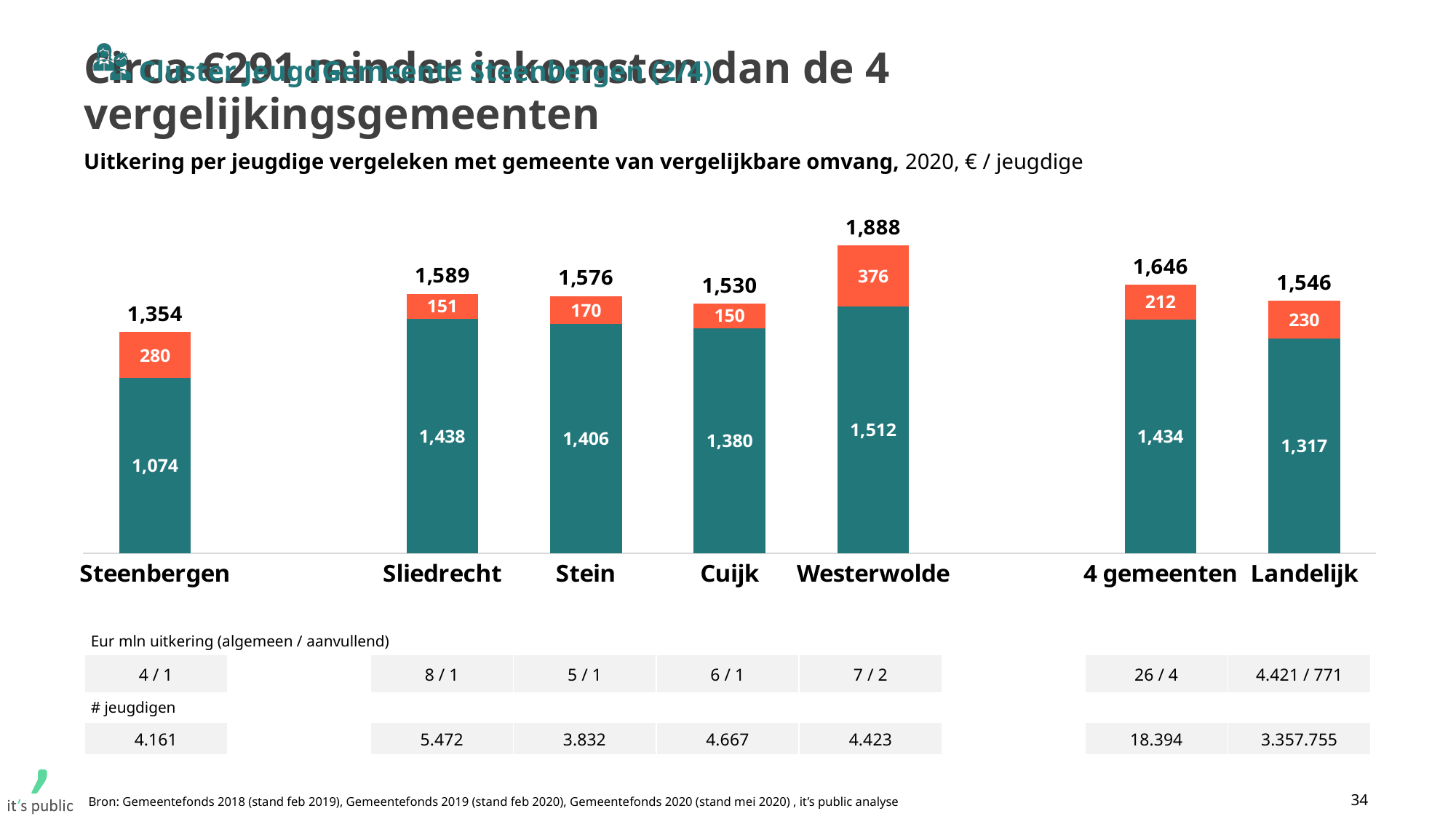
What kind of chart is shown on the slide? Stacked bar chart Which category has the highest total value? Westerwolde What is the difference between the teal (bottom) segments of Westerwolde and Cuijk? 132 What is the total value shown above the bar for Westerwolde? 1,888 What is the value of the orange (top) segment of the Landelijk bar? 230 What unit is stated in the chart subtitle for the values? € / jeugdige What is the total of the Cuijk bar? 1,530 How many categories are shown on the x axis of the chart? 7 Which category has the lowest total value? Steenbergen Which has a larger orange (top) segment, Sliedrecht or Stein? Stein What is the difference between the total for 4 gemeenten and the total for Steenbergen? 292 What is the value of the teal (bottom) segment of the Steenbergen bar? 1,074